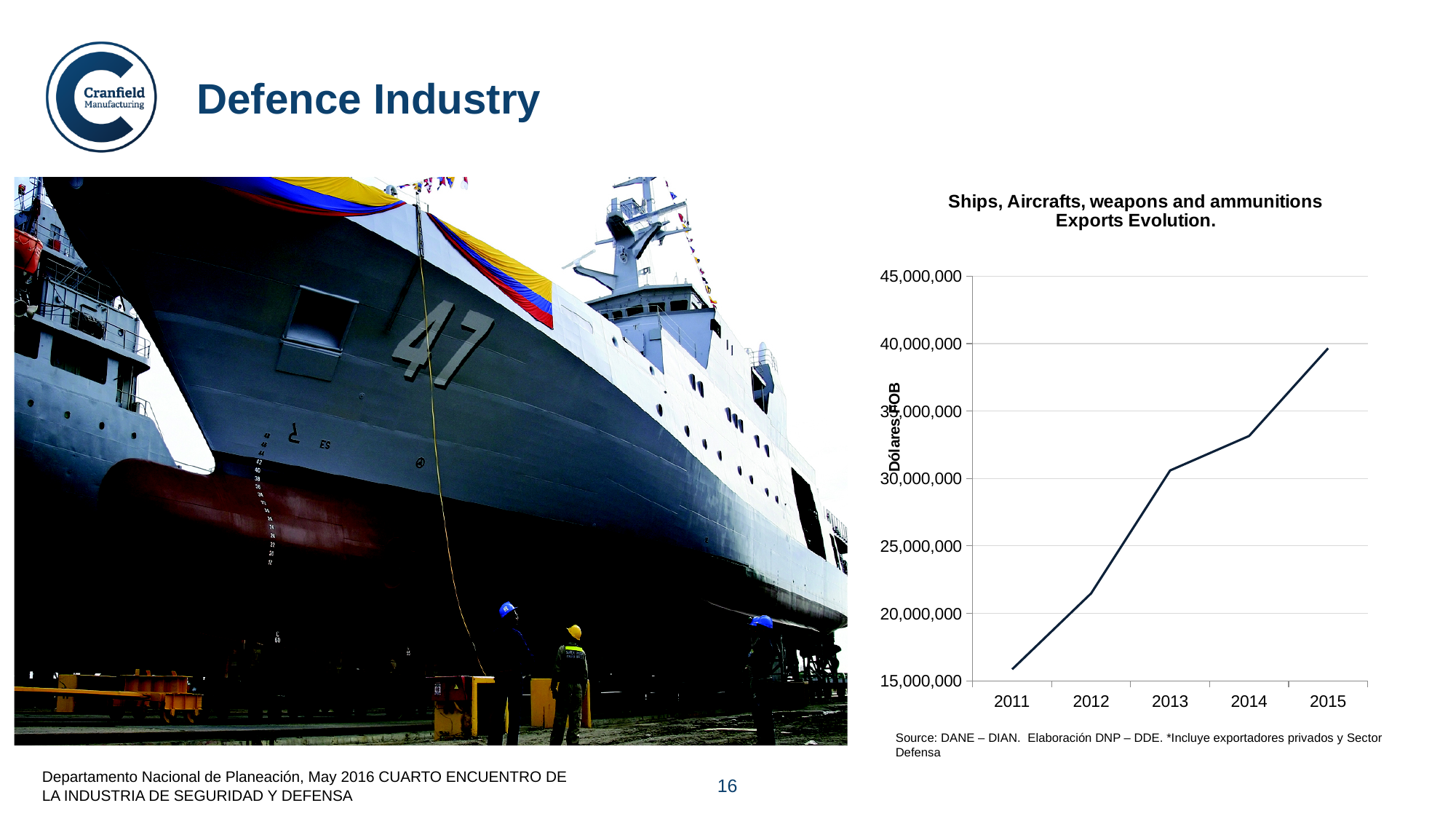
Do the export values rise or fall from 2011 to 2015? rise What is the title of the chart? Ships, Aircrafts, weapons and ammunitions Exports Evolution. How many years are plotted on the x axis of the chart? 5 Is the value for 2014 greater or less than 35,000,000? less Which year has the highest export value in the chart? 2015 Which year has the lowest export value in the chart? 2011 Is the value for 2015 greater or less than 35,000,000? greater Is the value for 2011 greater or less than 20,000,000? less What is the label on the vertical axis of the chart? Dólares FOB What kind of chart is shown on the slide? line chart Which year has the larger export value, 2012 or 2014? 2014